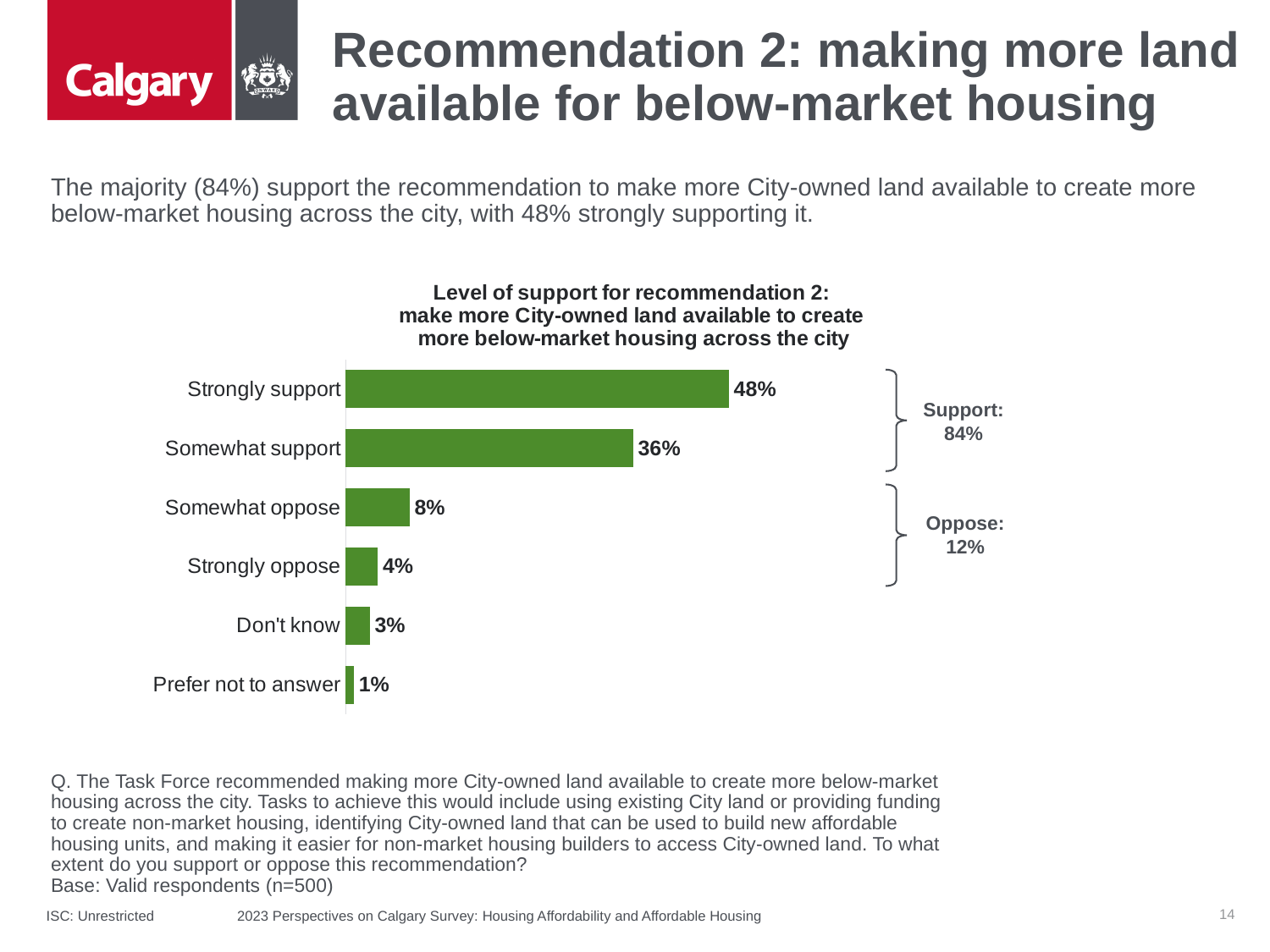
How many categories are shown in the chart? 6 What total percentage is shown for Support on the chart? 84% What total percentage is shown for Oppose on the chart? 12% What kind of chart is shown on the slide? Bar chart Which category has the highest value? Strongly support What percentage of respondents strongly support recommendation 2? 48% Which category has the lowest value? Prefer not to answer What is the difference between Somewhat oppose and Strongly oppose? 4% What is the value for Somewhat oppose? 8% What is the value for Prefer not to answer? 1% Which is larger, Strongly oppose or Don't know? Strongly oppose What is the difference between Strongly support and Somewhat support? 12%